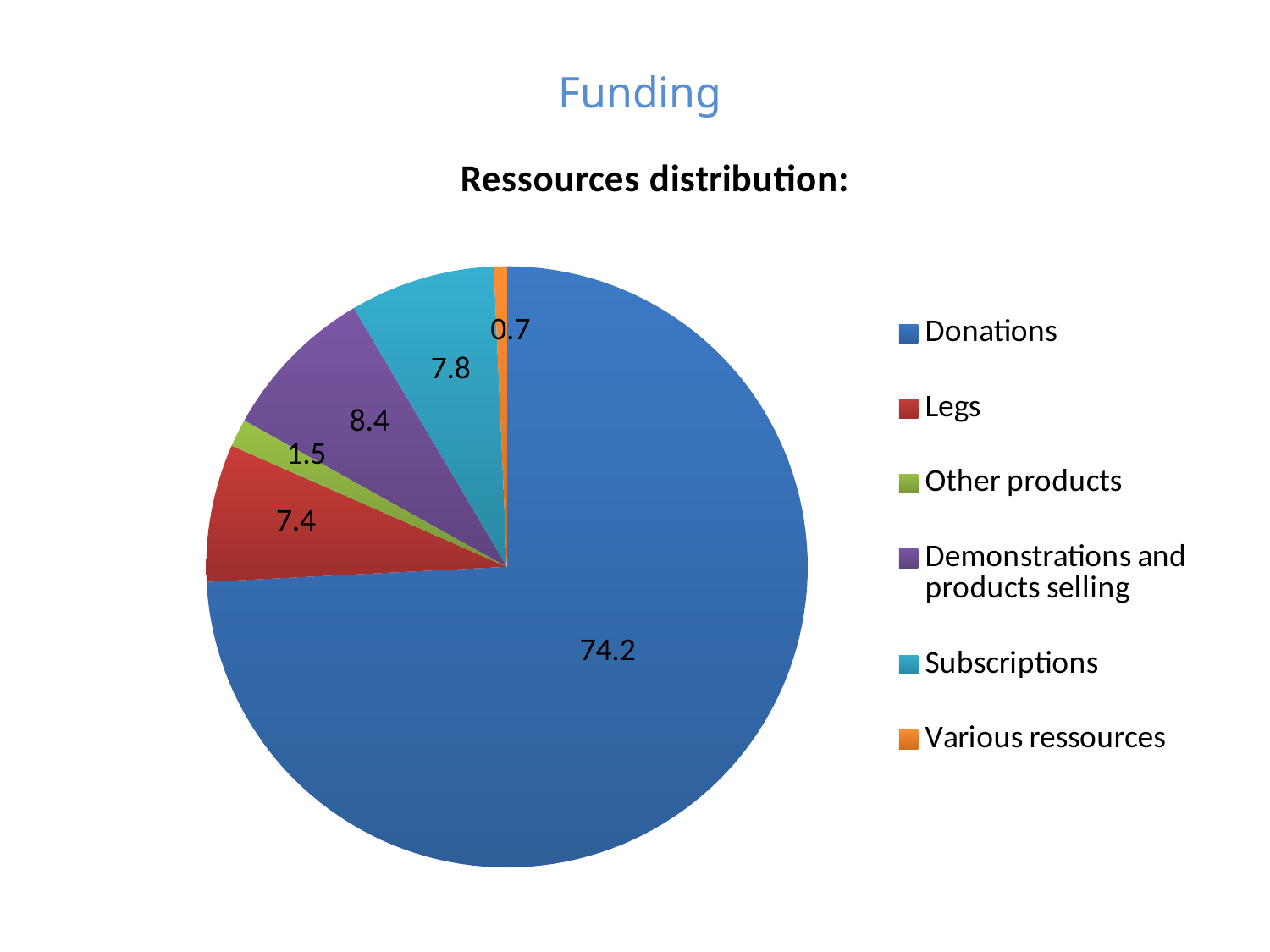
Which category has the smallest slice? Various ressources What kind of chart is shown on the slide? pie chart What is the value for Donations? 74.2 What is the value for Demonstrations and products selling? 8.4 Which is larger, the value for Other products or the value for Legs? Legs What is the value for Various ressources? 0.7 What is the value for Subscriptions? 7.8 What is the value for Legs? 7.4 How many categories does the legend list? 6 Which category has the largest slice? Donations What is the difference between the values for Donations and Subscriptions? 66.4 What is the title of the chart? Ressources distribution: